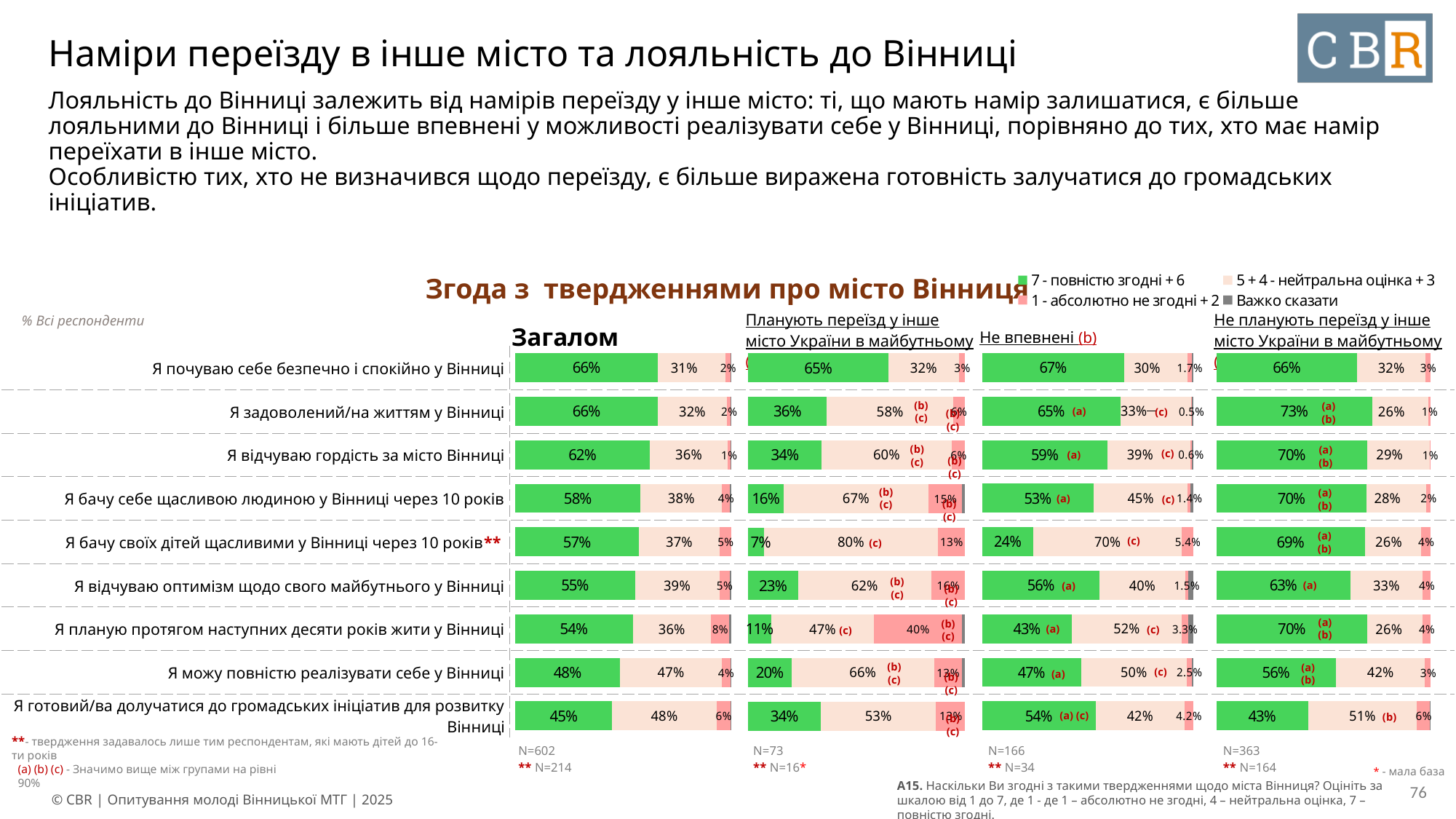
What is the sample size (N) shown for the 'Планують переїзд у інше місто України в майбутньому' group? N=73 What type of chart is used to show agreement with the statements? Stacked bar chart How many statements about Vinnytsia are listed in the charts? 9 In the 'Планують переїзд у інше місто України в майбутньому' chart, what share disagree (1 + 2) with 'Я планую протягом наступних десяти років жити у Вінниці'? 40% In the 'Загалом' chart, what share of respondents fully agree (7 + 6) with 'Я почуваю себе безпечно і спокійно у Вінниці'? 66% In the 'Не планують переїзд у інше місто України в майбутньому' chart, which statement has the highest share of '7 - повністю згодні + 6'? Я задоволений/на життям у Вінниці In the 'Не впевнені' chart, what share agree (7 + 6) with 'Я готовий/ва долучатися до громадських ініціатив для розвитку Вінниці'? 54% For 'Я планую протягом наступних десяти років жити у Вінниці', how many percentage points higher is the agree share in the 'Не планують переїзд' chart than in the 'Загалом' chart? 16 percentage points For 'Я бачу своїх дітей щасливими у Вінниці через 10 років', which group has the larger agree share: 'Не впевнені' or 'Планують переїзд'? Не впевнені In the 'Планують переїзд у інше місто України в майбутньому' chart, which statement has the lowest share of '7 - повністю згодні + 6'? Я бачу своїх дітей щасливими у Вінниці через 10 років In the 'Загалом' chart, which statement has the lowest share of '7 - повністю згодні + 6'? Я готовий/ва долучатися до громадських ініціатив для розвитку Вінниці How many series does the legend list? 4